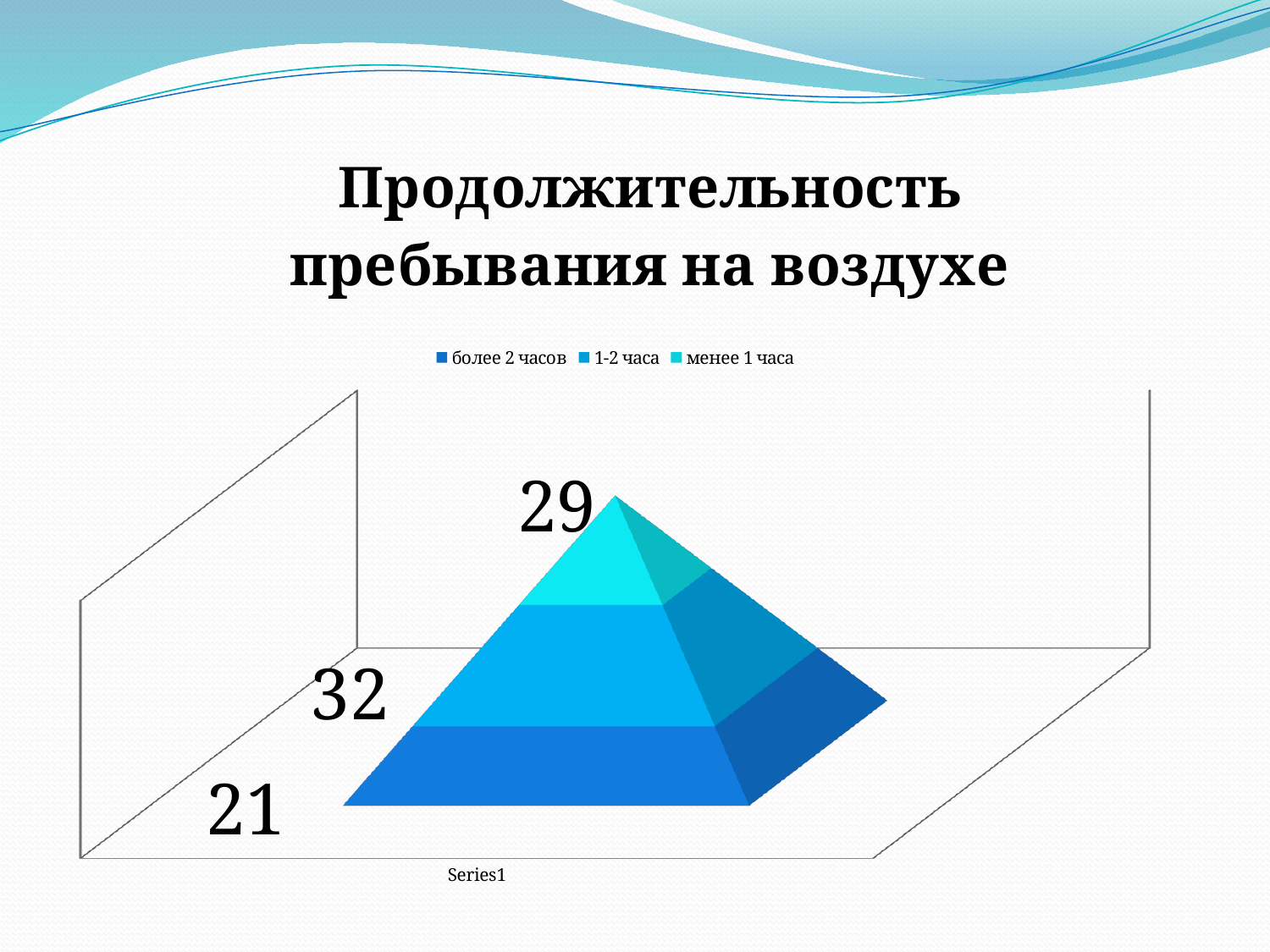
What is the value for "менее 1 часа"? 29 Which series has the highest value? 1-2 часа How many series does the legend list? 3 What is the value for "более 2 часов"? 21 What is the title of the chart? Продолжительность пребывания на воздухе What is the value for "1-2 часа"? 32 Which series has the lowest value? более 2 часов What is the total of all segments in the stacked pyramid? 82 What is the category label shown on the horizontal axis? Series1 Which is larger, the value for "менее 1 часа" or the value for "более 2 часов"? менее 1 часа What is the difference between the values for "1-2 часа" and "менее 1 часа"? 3 What is the difference between the values for "1-2 часа" and "более 2 часов"? 11